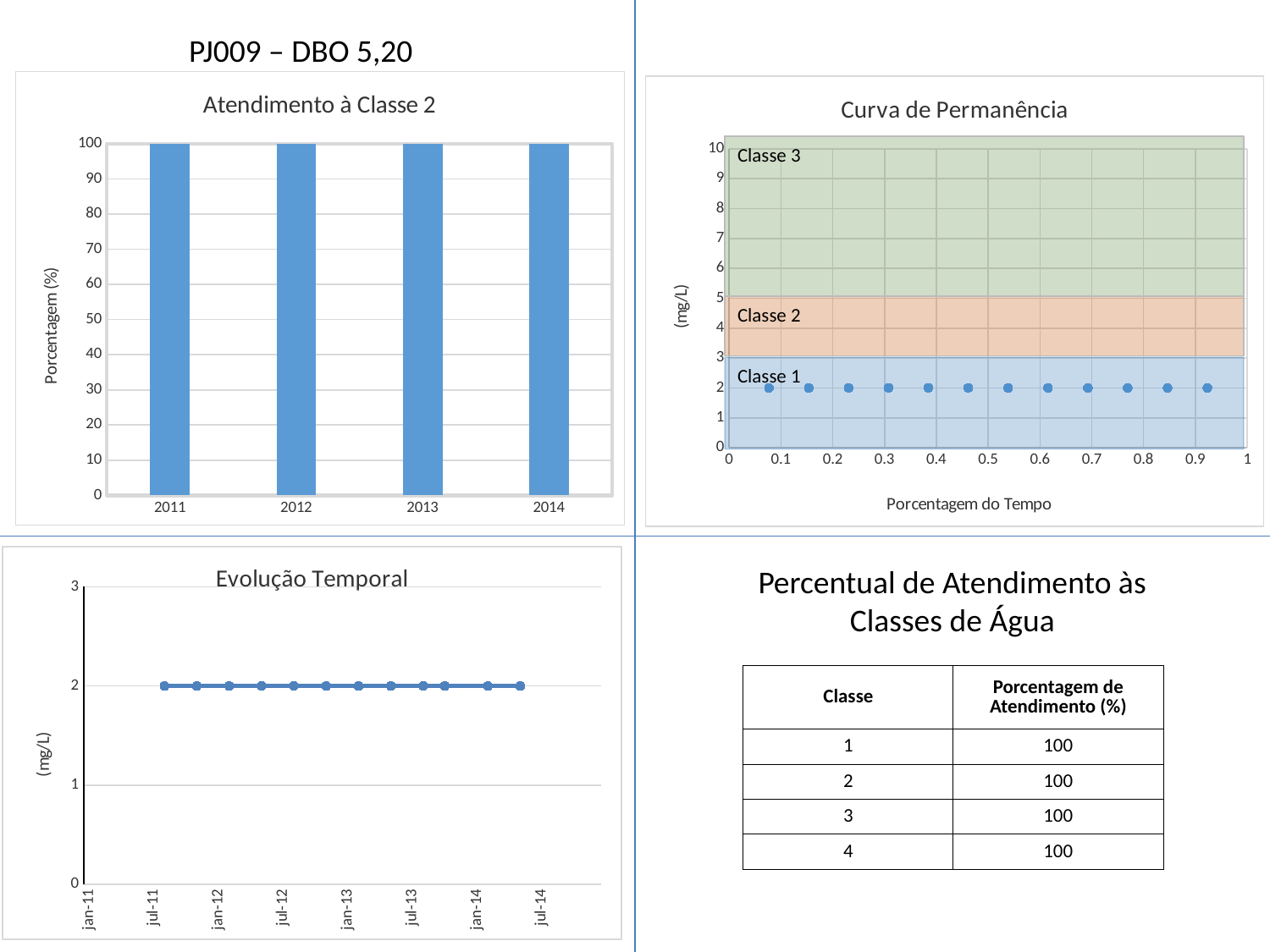
In the 'Atendimento à Classe 2' chart, what is the value for 2011? 100 How many bars are shown in the 'Atendimento à Classe 2' chart? 4 What is the y-axis label of the 'Atendimento à Classe 2' chart? Porcentagem (%) In the 'Curva de Permanência' chart, is the value of the plotted points greater or less than 3 mg/L? less How many data points are plotted in the 'Curva de Permanência' chart? 12 In the 'Evolução Temporal' chart, do the values rise, fall or stay flat over time? stay flat In the 'Atendimento à Classe 2' chart, what is the difference between the values for 2012 and 2013? 0 In the 'Curva de Permanência' chart, in which class band do the plotted points lie? Classe 1 In the 'Atendimento à Classe 2' chart, do the values rise, fall or stay flat from 2011 to 2014? stay flat In the 'Atendimento à Classe 2' chart, what is the value for 2014? 100 What kind of chart is 'Atendimento à Classe 2'? bar chart In the 'Evolução Temporal' chart, what value (mg/L) do the plotted points have? 2